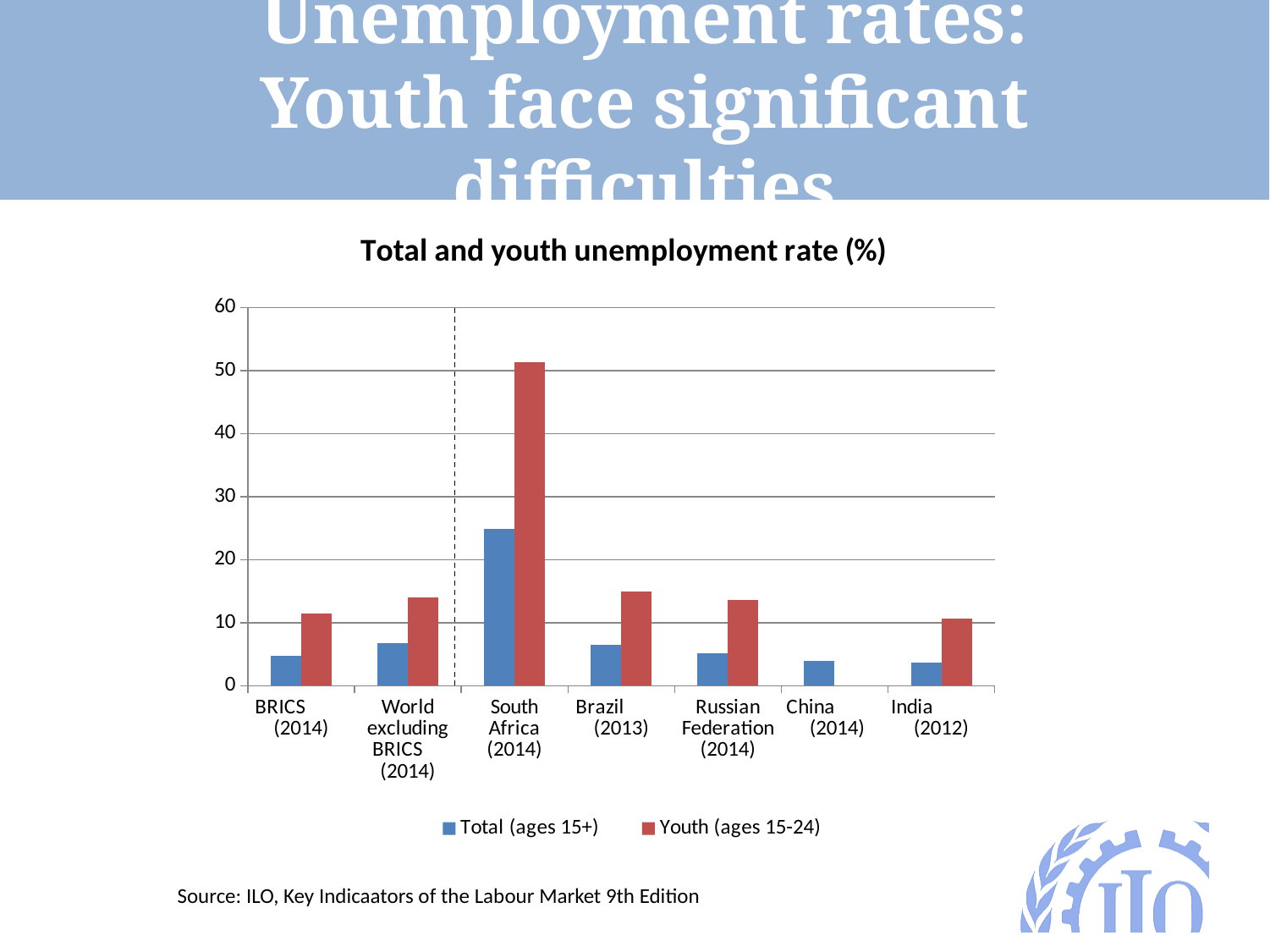
Is the Total (ages 15+) value for China (2014) greater or less than 10? less How many categories are shown on the x axis? 7 What is the title of the chart? Total and youth unemployment rate (%) Which category has the highest Youth (ages 15-24) unemployment rate? South Africa (2014) Is the Total (ages 15+) value for South Africa (2014) greater or less than 20? greater Which is larger, the Total (ages 15+) value for Brazil (2013) or for China (2014)? Brazil (2013) Which is larger, the Youth (ages 15-24) value for South Africa (2014) or for Brazil (2013)? South Africa (2014) How many series does the legend list? 2 Which category has the highest Total (ages 15+) unemployment rate? South Africa (2014) Is the Youth (ages 15-24) value for World excluding BRICS (2014) greater or less than 10? greater What kind of chart is shown on the slide? bar chart